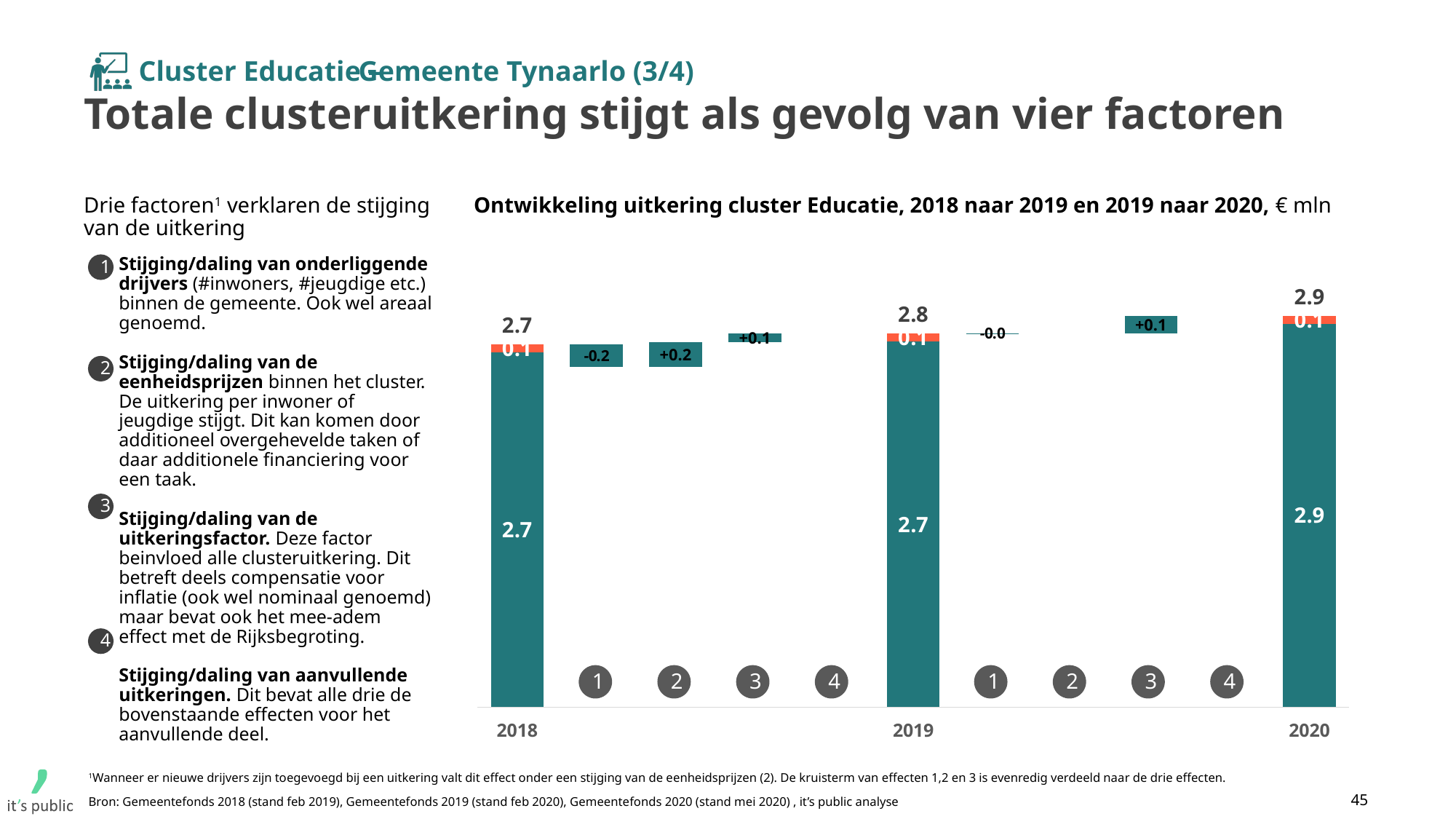
What is the difference between the total uitkering in 2020 and in 2018? 0.2 What is the total uitkering shown above the 2018 bar? 2.7 What is the total uitkering shown above the 2020 bar? 2.9 What kind of chart is shown on the slide? bar chart (waterfall) In what unit are the values in the chart expressed? € mln What is the total uitkering shown above the 2019 bar? 2.8 What is the value of factor 3 in the change from 2019 to 2020? +0.1 What is the value of factor 2 in the change from 2018 to 2019? +0.2 What is the value of factor 1 in the change from 2018 to 2019? -0.2 Which year has the lowest total uitkering? 2018 Do the total uitkering values rise or fall from 2018 to 2020? rise Which year has the highest total uitkering? 2020